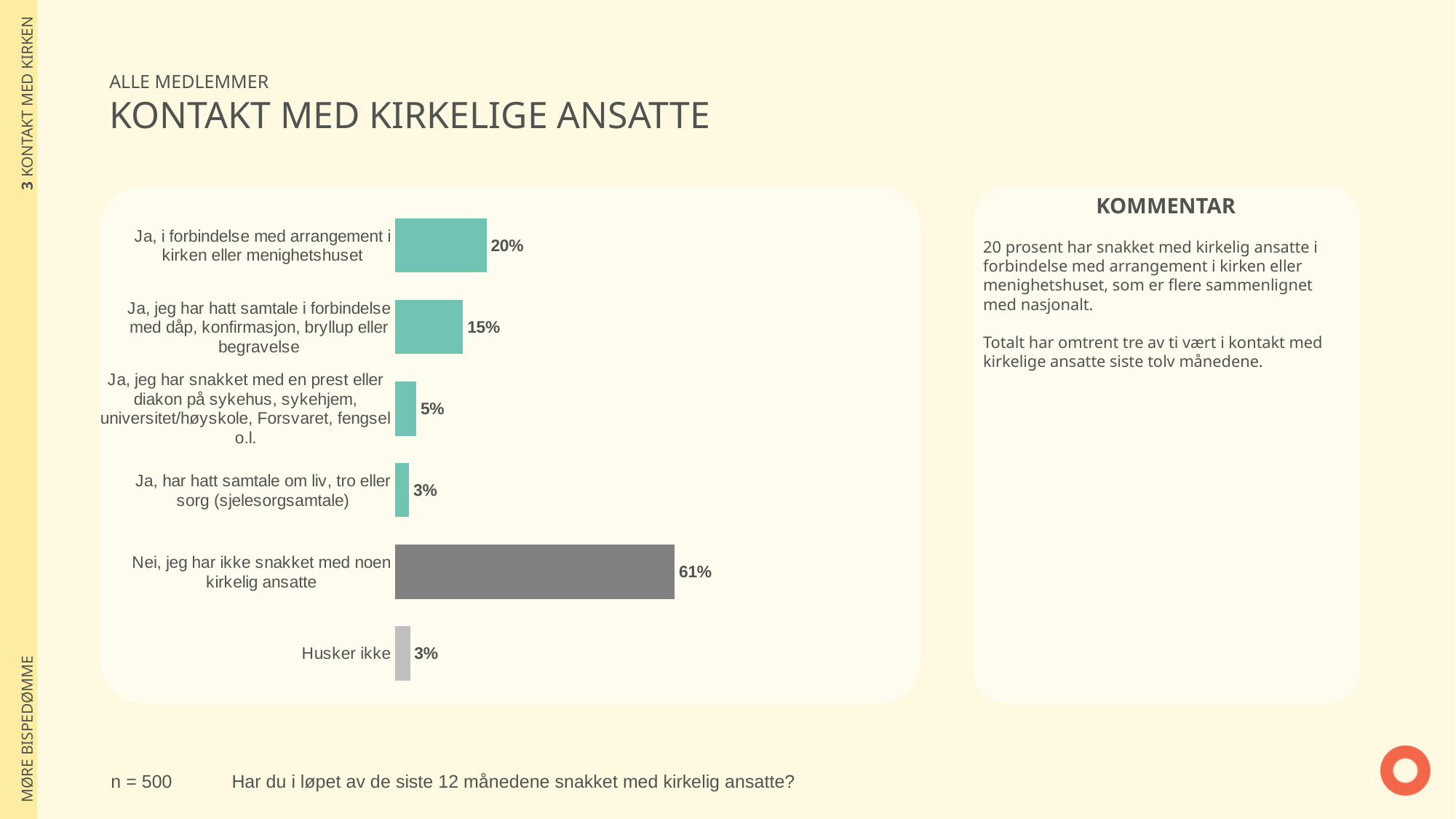
What is the difference between the values for "Ja, i forbindelse med arrangement i kirken eller menighetshuset" and "Ja, jeg har hatt samtale i forbindelse med dåp, konfirmasjon, bryllup eller begravelse"? 5% What is the sample size (n) stated on the slide? n = 500 What is the difference between the values for "Nei, jeg har ikke snakket med noen kirkelig ansatte" and "Ja, i forbindelse med arrangement i kirken eller menighetshuset"? 41% What is the value for "Nei, jeg har ikke snakket med noen kirkelig ansatte"? 61% How many categories are shown in the chart? 6 What colour is the bar for "Nei, jeg har ikke snakket med noen kirkelig ansatte"? Dark grey What is the value for "Ja, i forbindelse med arrangement i kirken eller menighetshuset"? 20% Which is larger: the value for "Ja, jeg har snakket med en prest eller diakon på sykehus, sykehjem, universitet/høyskole, Forsvaret, fengsel o.l." or the value for "Ja, har hatt samtale om liv, tro eller sorg (sjelesorgsamtale)"? Ja, jeg har snakket med en prest eller diakon på sykehus, sykehjem, universitet/høyskole, Forsvaret, fengsel o.l. What kind of chart is shown on the slide? Bar chart What is the value for "Husker ikke"? 3% What is the value for "Ja, jeg har hatt samtale i forbindelse med dåp, konfirmasjon, bryllup eller begravelse"? 15% Which category has the highest value? Nei, jeg har ikke snakket med noen kirkelig ansatte